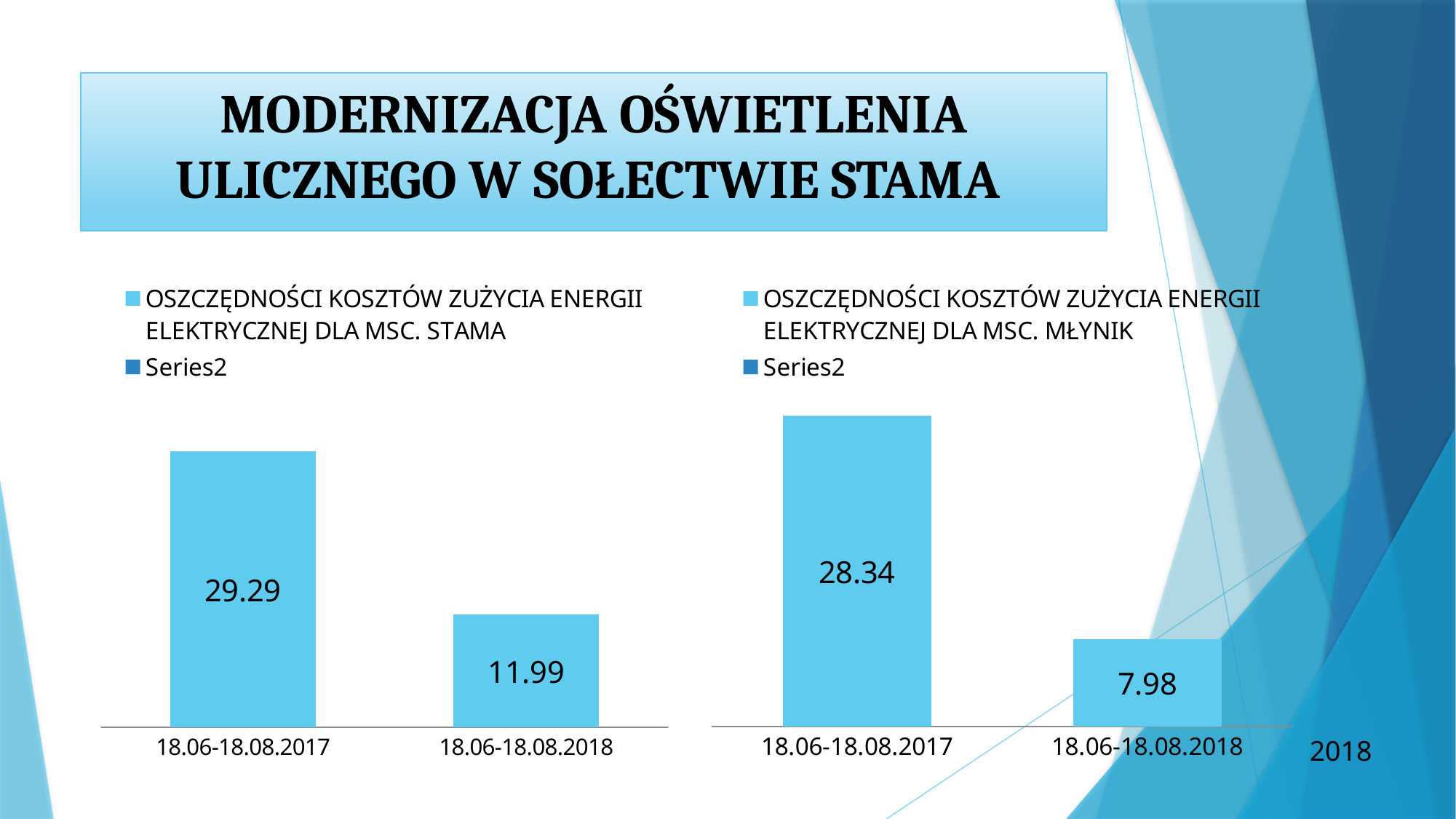
In the left chart (MSC. STAMA), which period has the highest value? 18.06-18.08.2017 In the right chart (MSC. MŁYNIK), what is the value for 18.06-18.08.2018? 7.98 In the left chart (MSC. STAMA), what is the difference between the 2017 and 2018 values? 17.30 In the right chart (MSC. MŁYNIK), what is the value for 18.06-18.08.2017? 28.34 In the right chart (MSC. MŁYNIK), what is the difference between the 2017 and 2018 values? 20.36 In the left chart (MSC. STAMA), what is the value for 18.06-18.08.2018? 11.99 Which is larger: the 2018 value in the left chart (MSC. STAMA) or the 2018 value in the right chart (MSC. MŁYNIK)? Left chart (MSC. STAMA), 11.99 How many series does the legend of the right chart (MSC. MŁYNIK) list? 2 In the left chart (MSC. STAMA), what is the value for 18.06-18.08.2017? 29.29 In the right chart (MSC. MŁYNIK), which period has the lowest value? 18.06-18.08.2018 How many categories are shown on the x axis of the left chart (MSC. STAMA)? 2 What type of chart is the left chart (MSC. STAMA)? Bar chart